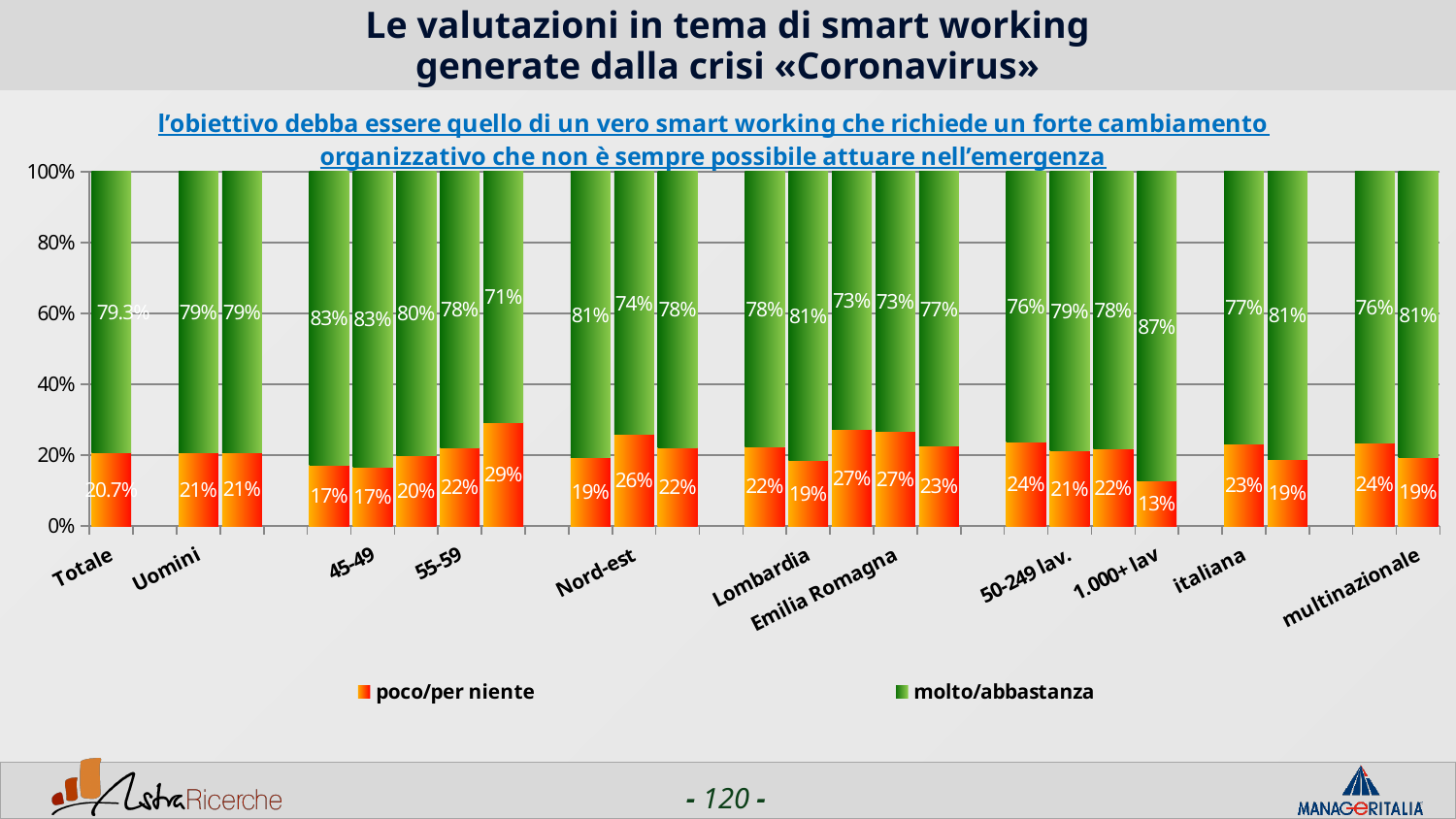
What kind of chart is shown on the slide? Stacked bar chart What colour represents the poco/per niente series? Orange How many series does the legend list? 2 What is the poco/per niente value for Totale? 20.7% What is the molto/abbastanza value for 1.000+ lav? 87% What is the molto/abbastanza value for Emilia Romagna? 73% What is the poco/per niente value for Nord-est? 26% Which category has the lowest poco/per niente value? 1.000+ lav What is the molto/abbastanza value for Totale? 79.3% Which has the larger poco/per niente value, Nord-est or Lombardia? Nord-est Which category has the highest molto/abbastanza value? 1.000+ lav For Uomini, what is the difference between the molto/abbastanza value and the poco/per niente value? 58%